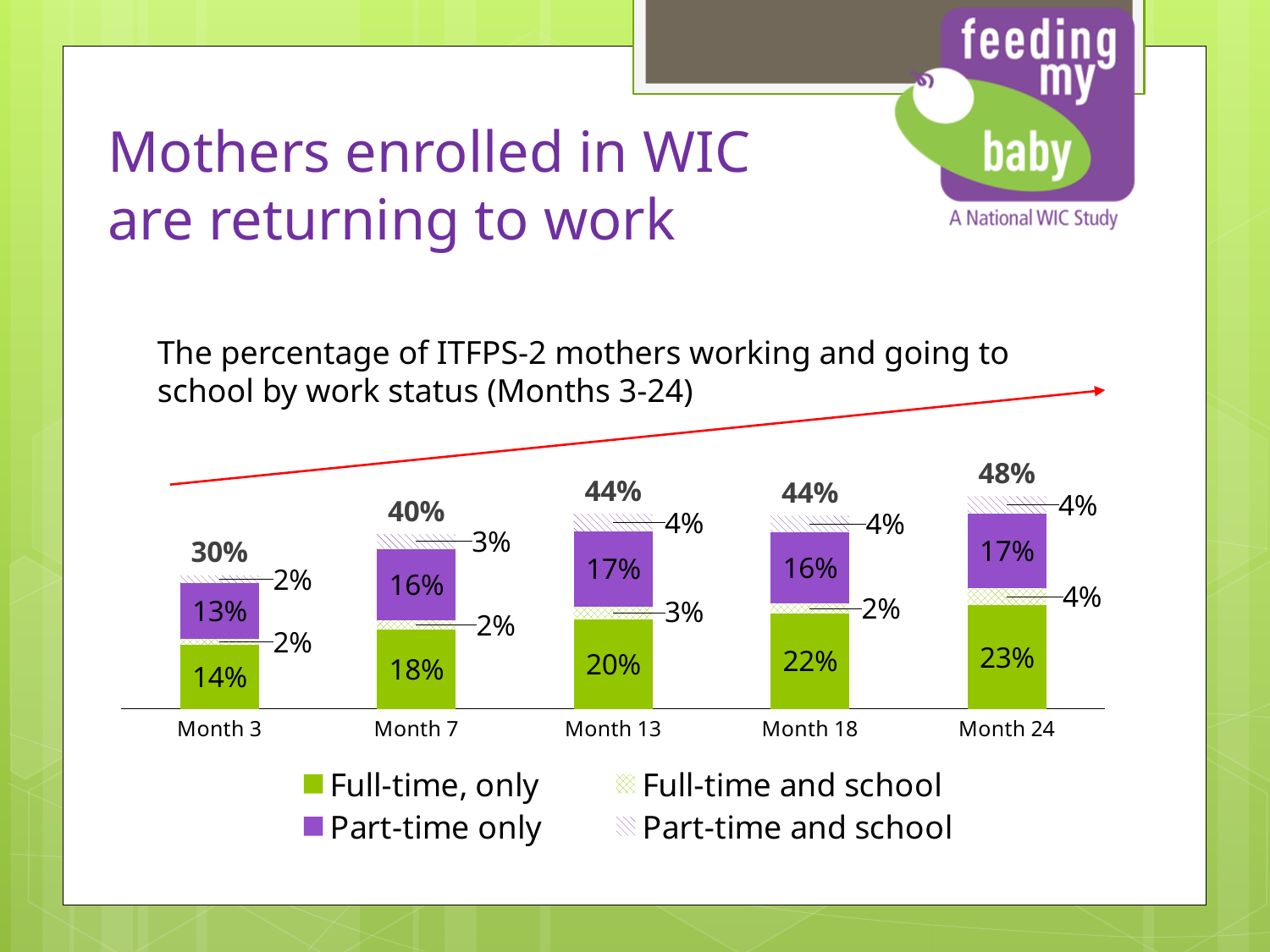
How many months (categories) are shown on the x axis? 5 How many series does the legend list? 4 What kind of chart is shown on the slide? Stacked bar chart At Month 18, which is larger: Full-time, only or Part-time only? Full-time, only What is the value for Part-time only at Month 7? 16% What is the total percentage shown above the Month 13 bar? 44% What is the difference between the Full-time, only value at Month 24 and at Month 3? 9% Which month has the highest total percentage of mothers working? Month 24 Which month has the lowest total percentage of mothers working? Month 3 What is the value for Full-time, only at Month 24? 23% What is the value for Full-time and school at Month 13? 3% Does the Full-time, only value rise or fall from Month 3 to Month 24? Rise